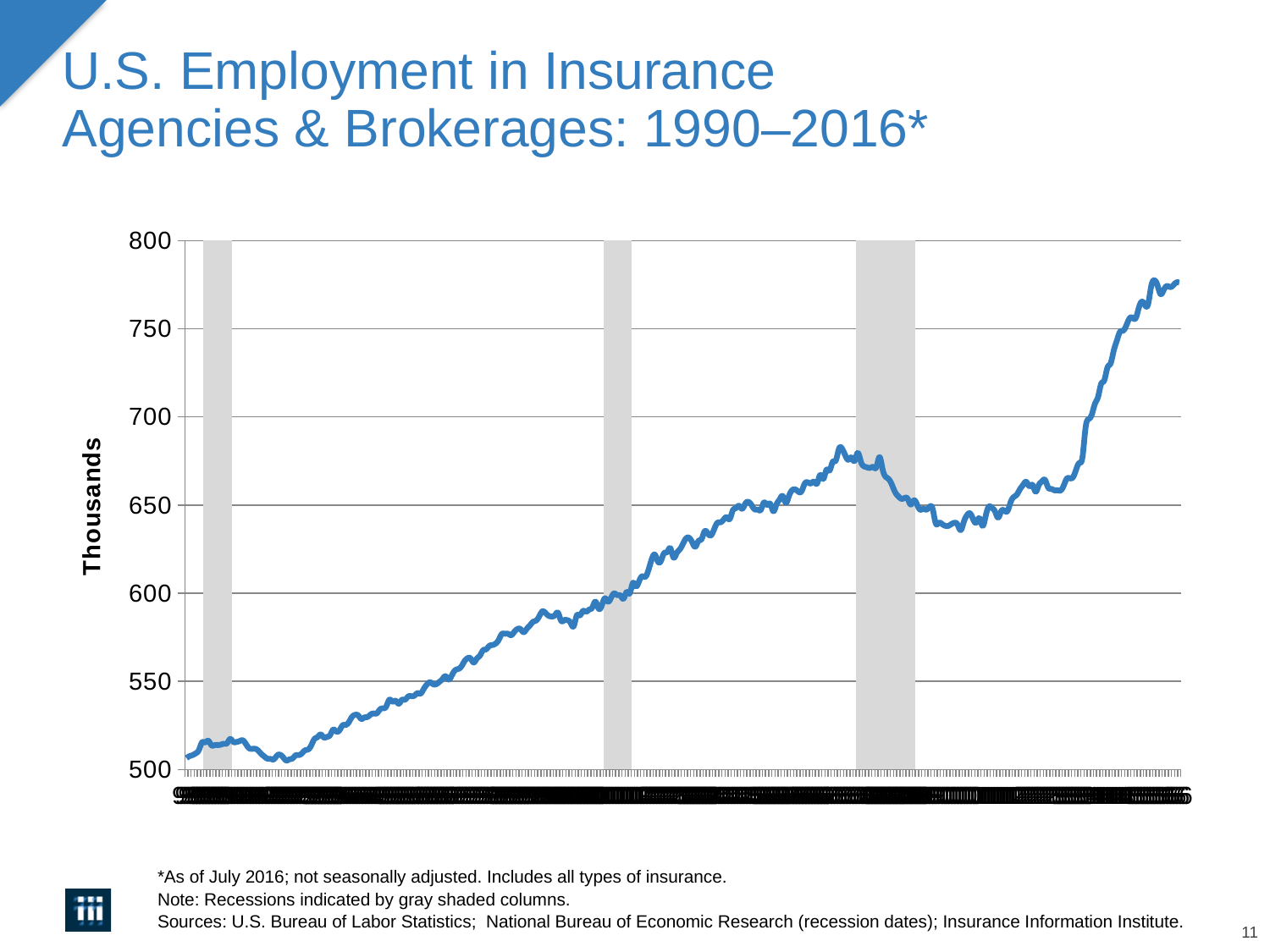
Is the value at the far right end of the line larger or smaller than the value at the far left start? larger What is the label on the vertical axis of the chart? Thousands Is the value at the far left start of the line greater or less than 550? less What kind of chart is shown on the slide? line chart Is the value at the far right end of the line greater or less than 750? greater How many data series are plotted on the chart? 2 Overall, do the values rise or fall from the left of the x axis to the right? rise What is the title of the chart on the slide? U.S. Employment in Insurance Agencies & Brokerages: 1990–2016* How many gray shaded recession columns are shown on the chart? 3 What is the lowest value shown on the vertical axis? 500 Is the value at the far right end of the line greater or less than 800? less